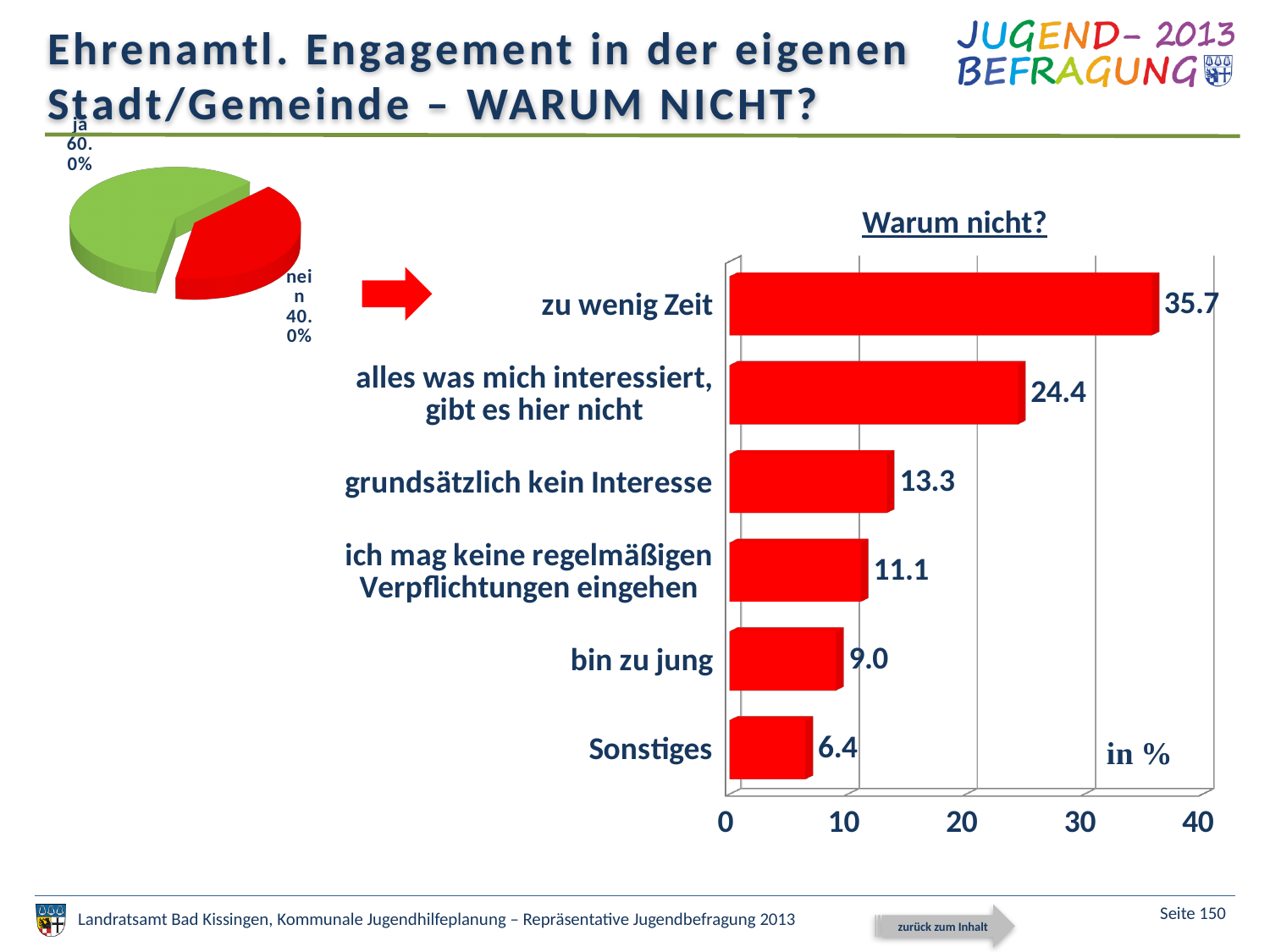
In the "Warum nicht?" bar chart, what is the value for "zu wenig Zeit"? 35.7 In the "Warum nicht?" bar chart, which is larger: "ich mag keine regelmäßigen Verpflichtungen eingehen" or "bin zu jung"? ich mag keine regelmäßigen Verpflichtungen eingehen How many categories does the "Warum nicht?" bar chart show? 6 In the "Warum nicht?" bar chart, what is the value for "grundsätzlich kein Interesse"? 13.3 In the "Warum nicht?" bar chart, is the value for "alles was mich interessiert, gibt es hier nicht" greater or less than 20? greater In the "Warum nicht?" bar chart, what is the difference between "zu wenig Zeit" and "alles was mich interessiert, gibt es hier nicht"? 11.3 In the pie chart on the left, what share does "nein" have? 40.0% In the "Warum nicht?" bar chart, what is the value for "bin zu jung"? 9.0 In the pie chart on the left, what share does "ja" have? 60.0% What kind of chart is the "Warum nicht?" chart on the right? bar chart In the "Warum nicht?" bar chart, which category has the lowest value? Sonstiges In the "Warum nicht?" bar chart, which category has the highest value? zu wenig Zeit